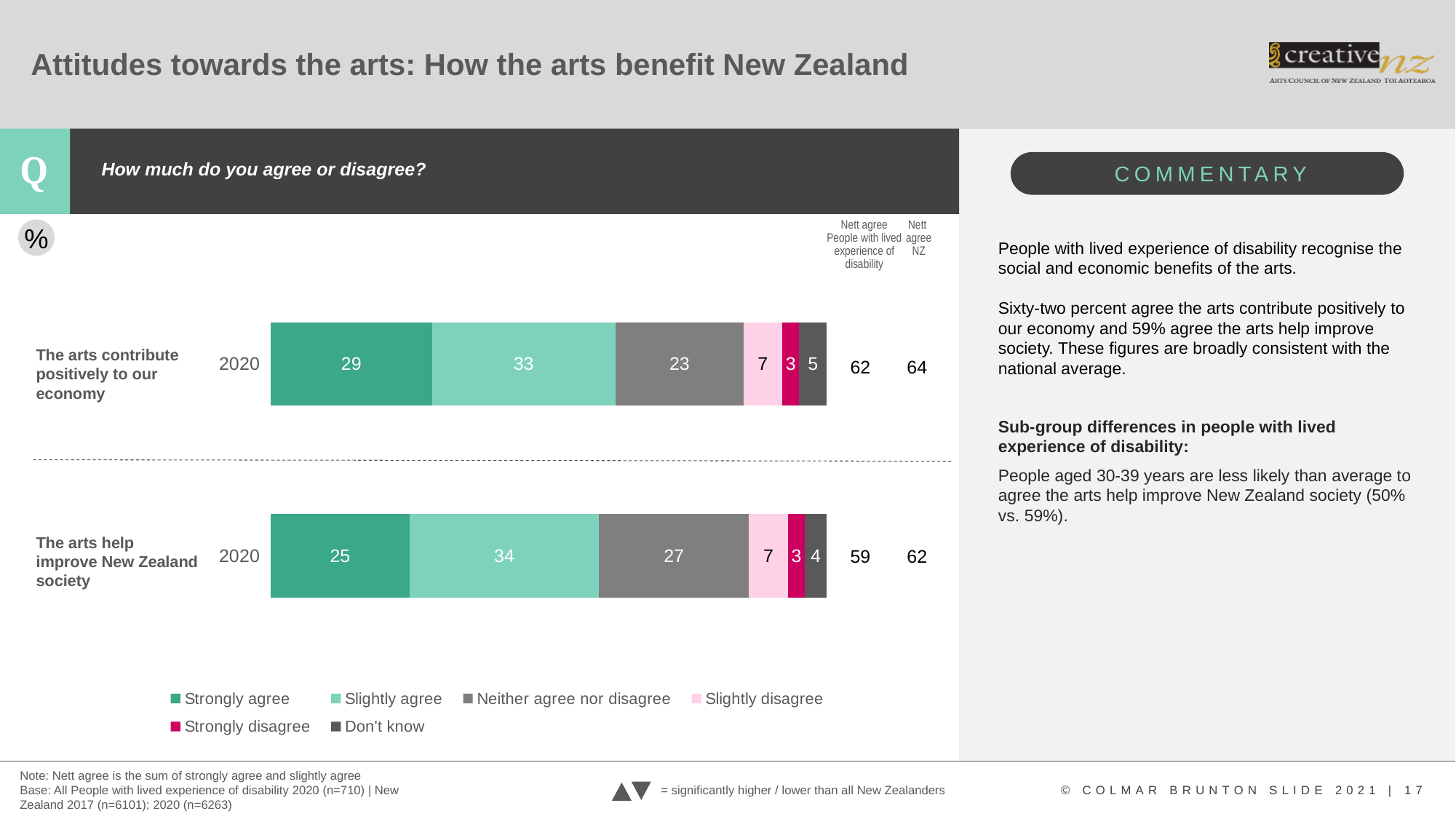
What is the Nett agree figure for people with lived experience of disability for 'The arts contribute positively to our economy'? 62 What is the difference between the 'Strongly agree' values for the two statements? 4 What percentage strongly agree that the arts contribute positively to our economy? 29 How many series does the legend list? 6 Which response category has the smallest share for 'The arts contribute positively to our economy'? Strongly disagree What percentage slightly agree that the arts help improve New Zealand society? 34 What is the 'Neither agree nor disagree' value for 'The arts help improve New Zealand society'? 27 What is the total of the stacked bar for 'The arts help improve New Zealand society'? 100 Which response category has the largest share for 'The arts contribute positively to our economy'? Slightly agree What is the Nett agree NZ figure for 'The arts help improve New Zealand society'? 62 Which statement has a higher 'Neither agree nor disagree' value? The arts help improve New Zealand society What kind of chart is shown on the slide? Stacked bar chart